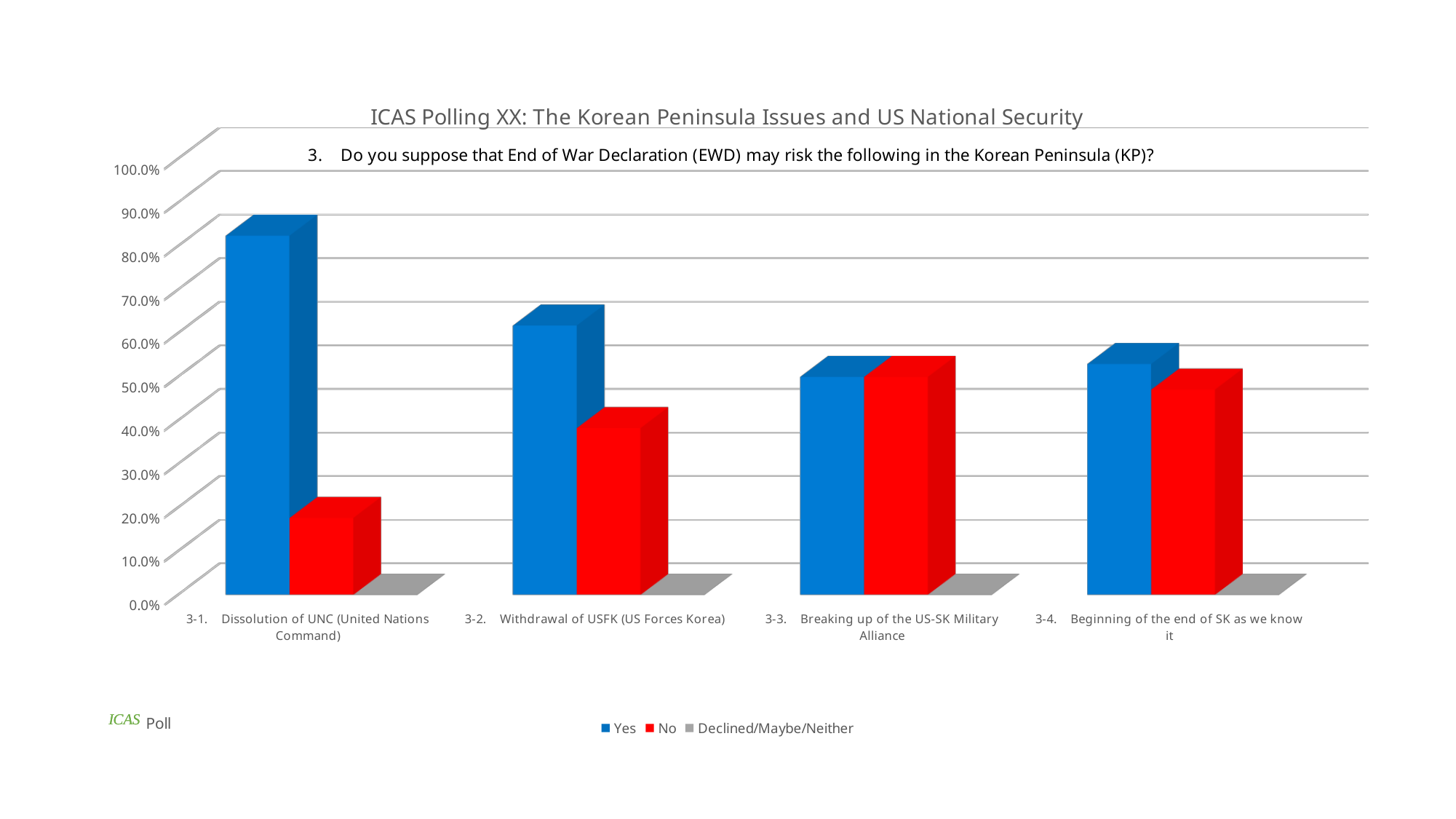
Which category has the highest Yes value? 3-1. Dissolution of UNC (United Nations Command) Is the No value for 3-2. Withdrawal of USFK greater or less than 50.0%? less Is the Yes value for 3-2. Withdrawal of USFK greater or less than 50.0%? greater Is the Yes value for 3-1. Dissolution of UNC greater or less than 70.0%? greater What are the three series named in the legend? Yes, No, Declined/Maybe/Neither For 3-2. Withdrawal of USFK, which is larger, the Yes value or the No value? Yes For 3-1. Dissolution of UNC, which is larger, the Yes value or the No value? Yes How many categories (risk items) are shown on the x axis? 4 Which category has the lowest No value? 3-1. Dissolution of UNC (United Nations Command) What kind of chart is shown on the slide? Bar chart How many series does the legend list? 3